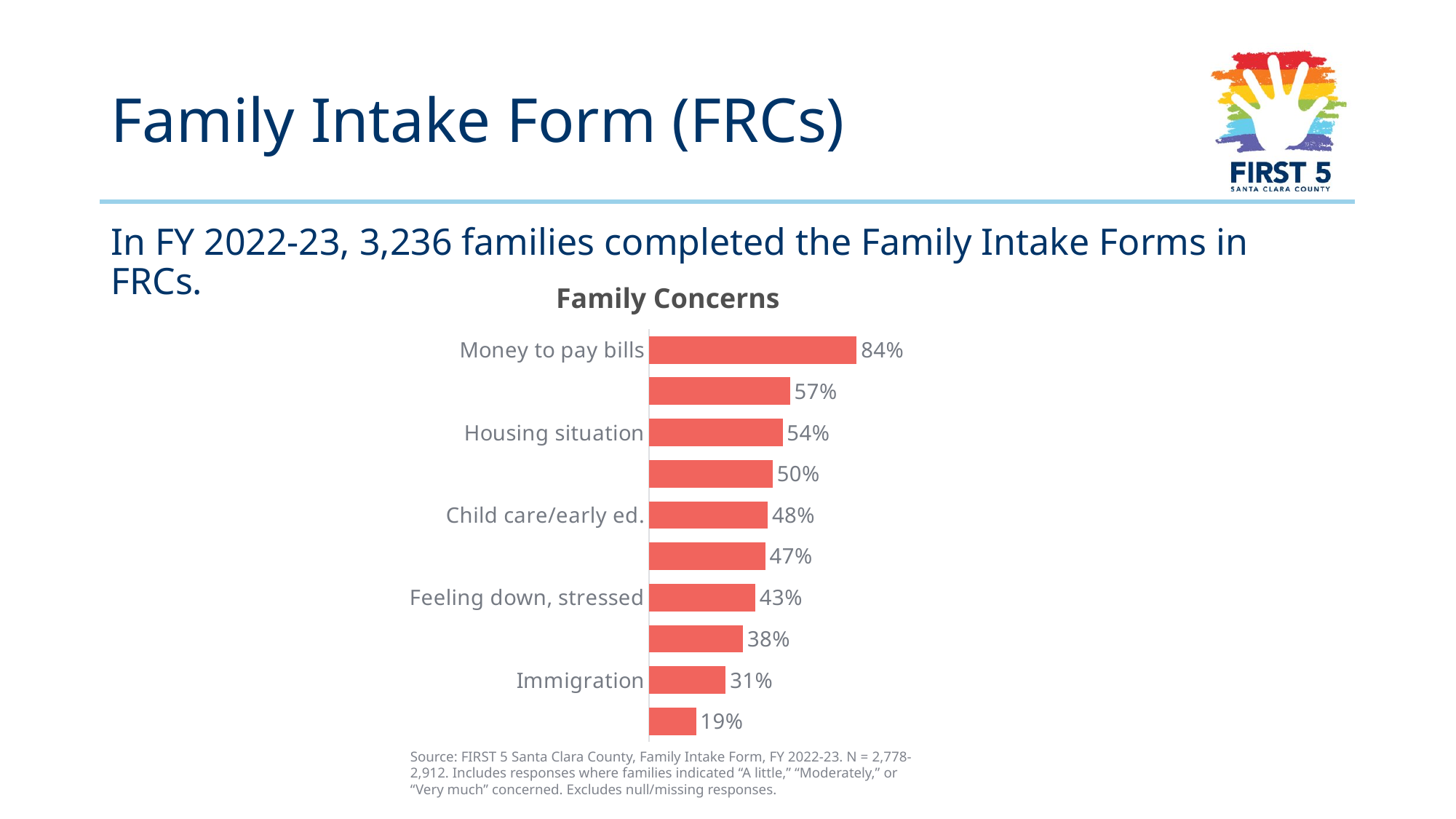
Which family concern has the highest percentage? Money to pay bills How many bars are plotted on the chart? 10 What type of chart is used to show Family Concerns? Bar chart What is the difference between the percentages for Money to pay bills and Housing situation? 30% What percentage is shown for Child care/early ed.? 48% What percentage of families reported concern about money to pay bills? 84% What is the value shown for Housing situation? 54% What is the value for Feeling down, stressed? 43% What is the difference between the values for Child care/early ed. and Immigration? 17% Which is larger, the value for Housing situation or the value for Feeling down, stressed? Housing situation What is the lowest percentage value shown on the chart? 19% What percentage of families reported concern about Immigration? 31%